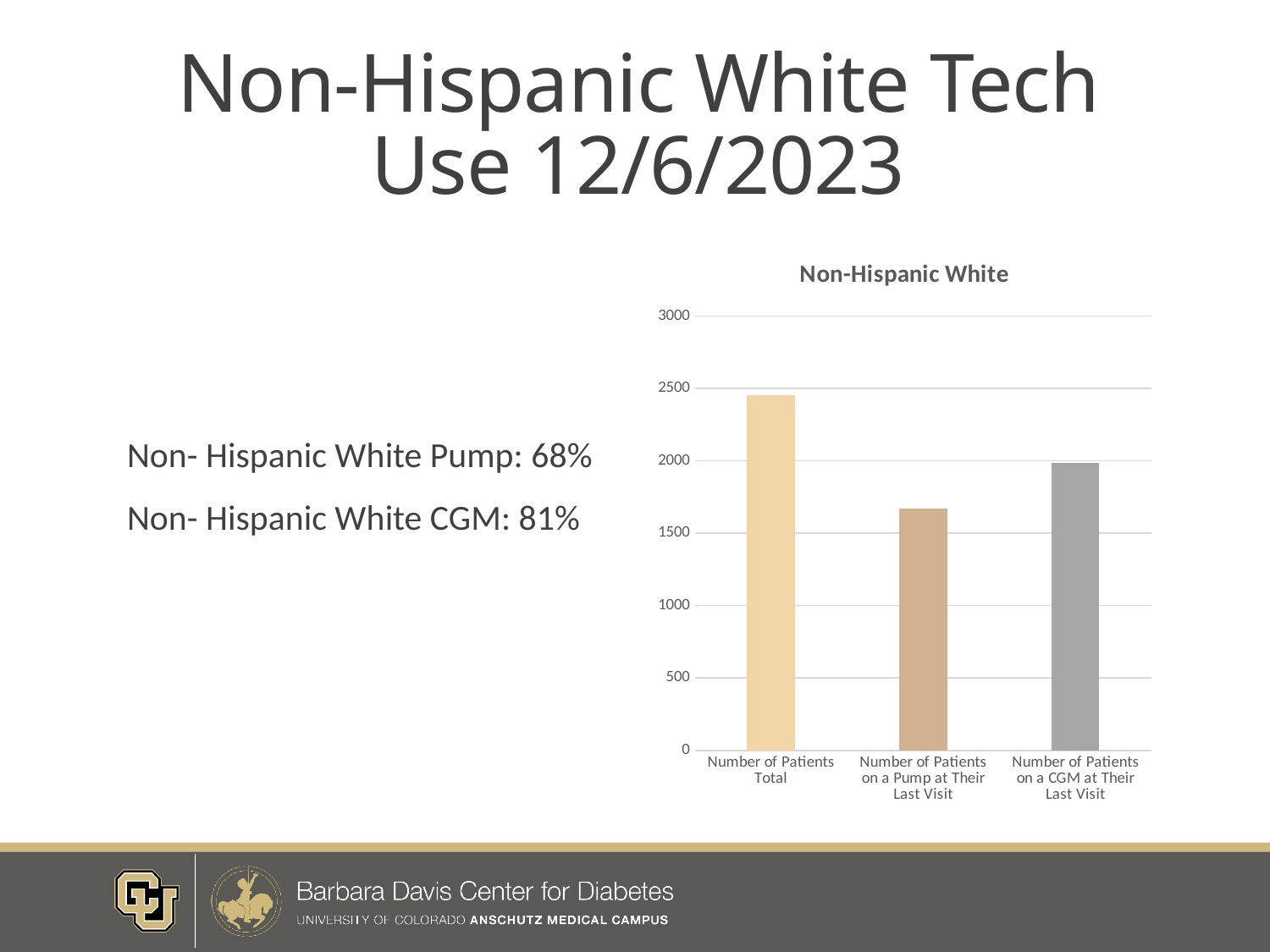
What is the highest value shown on the vertical axis of the chart? 3000 Which is larger: the number of patients on a CGM at their last visit or the number of patients on a pump at their last visit? Number of Patients on a CGM at Their Last Visit Is the value for Number of Patients on a CGM at Their Last Visit greater or less than 1500? greater What type of chart is shown on the slide? bar chart Which category has the highest bar? Number of Patients Total Which category has the lowest bar? Number of Patients on a Pump at Their Last Visit Is the value for Number of Patients Total greater or less than 2000? greater Is the value for Number of Patients on a Pump at Their Last Visit greater or less than 1500? greater What is the title of the chart? Non-Hispanic White How many categories are plotted in the chart? 3